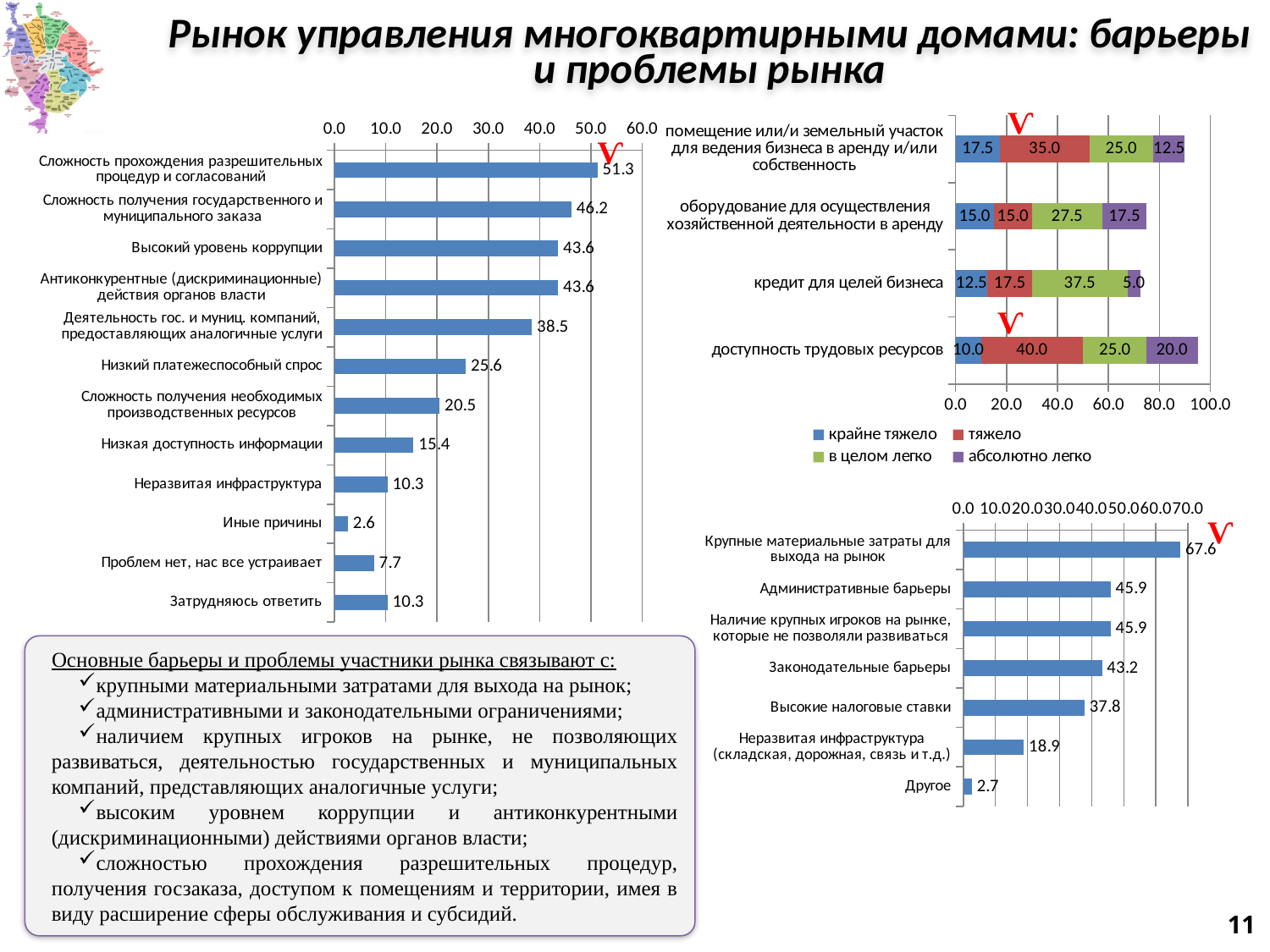
What kind of chart is the chart at the bottom right of the slide? Bar chart In the bar chart at the bottom right, which is larger: 'Законодательные барьеры' or 'Неразвитая инфраструктура (складская, дорожная, связь и т.д.)'? Законодательные барьеры In the stacked bar chart at the top right, what is the value of 'тяжело' for 'доступность трудовых ресурсов'? 40.0 In the bar chart on the left of the slide, which category has the lowest value? Иные причины In the stacked bar chart at the top right, what is the total of the bar for 'кредит для целей бизнеса'? 72.5 How many categories are shown in the bar chart on the left of the slide? 12 In the stacked bar chart at the top right, which series is shown in green? в целом легко In the bar chart on the left of the slide, what is the difference between 'Сложность получения государственного и муниципального заказа' and 'Низкий платежеспособный спрос'? 20.6 In the bar chart at the bottom right, what is the value for 'Высокие налоговые ставки'? 37.8 How many series does the legend of the stacked bar chart at the top right list? 4 In the bar chart at the bottom right, which category has the highest value? Крупные материальные затраты для выхода на рынок In the bar chart on the left of the slide, what is the value for 'Сложность прохождения разрешительных процедур и согласований'? 51.3